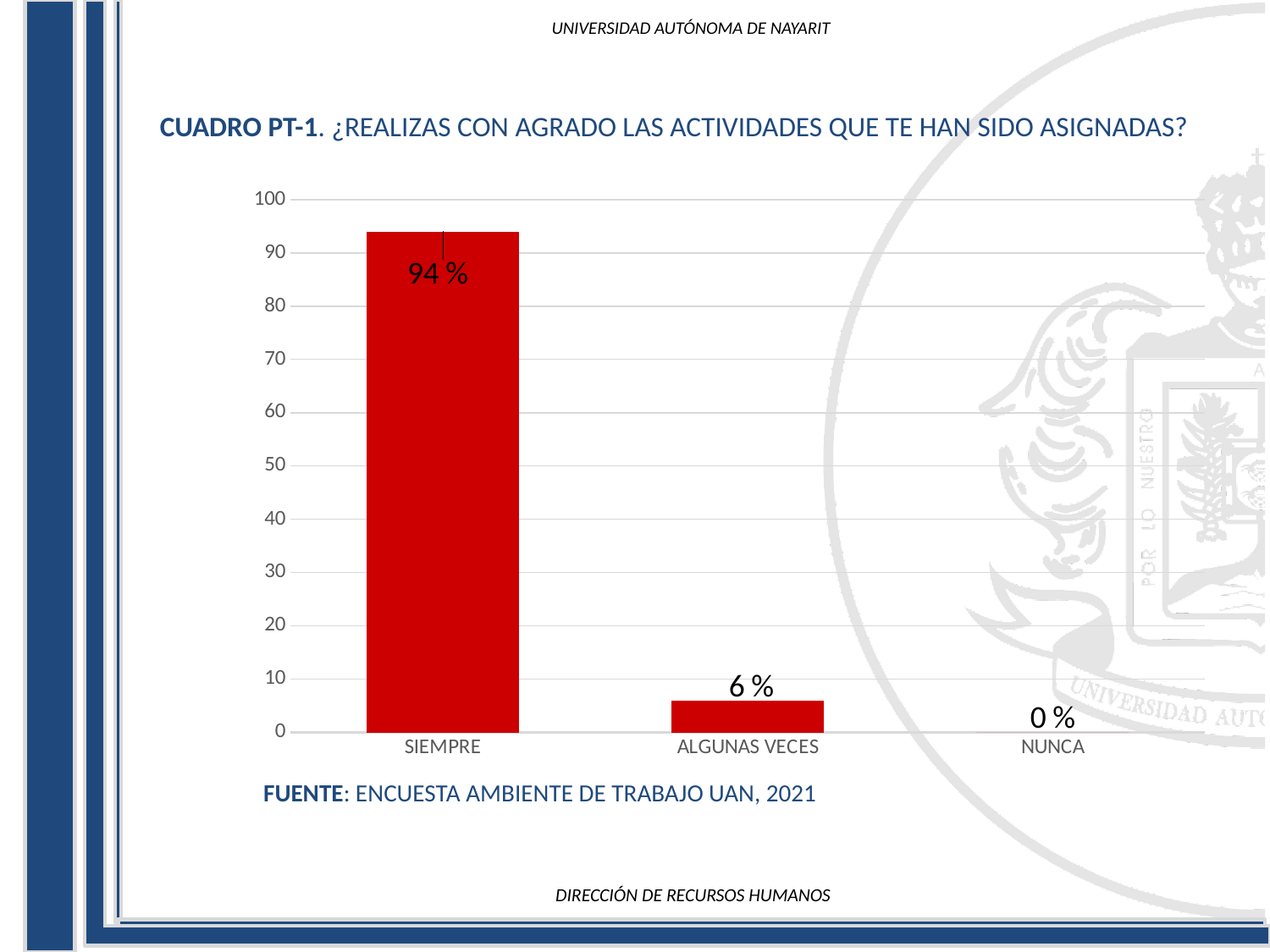
What is the difference between the values for SIEMPRE and ALGUNAS VECES? 88 % Is the value for SIEMPRE greater or less than 90? greater Which category has the highest value? SIEMPRE What kind of chart is shown on the slide? bar chart What is the value for SIEMPRE? 94 % Which is larger, the value for ALGUNAS VECES or the value for NUNCA? ALGUNAS VECES Which category has the lowest value? NUNCA What is the value for NUNCA? 0 % What is the value for ALGUNAS VECES? 6 % How many categories are shown on the x axis? 3 Is the value for ALGUNAS VECES greater or less than 10? less What colour are the bars in the chart? red